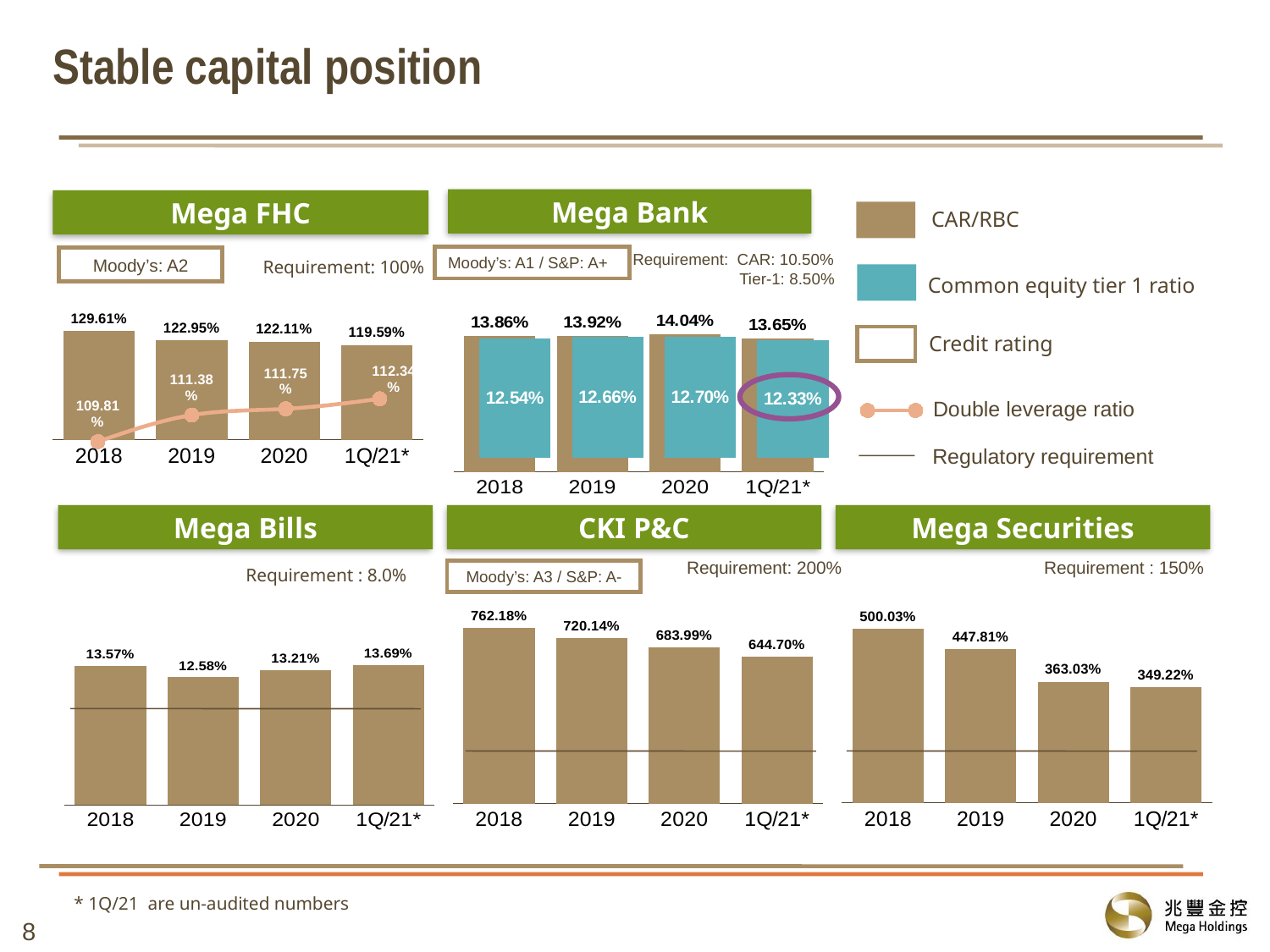
In the Mega FHC chart, what is the CAR/RBC value for 2018? 129.61% In the Mega Securities chart, which is larger, the value for 2020 or the value for 1Q/21*? 2020 How many periods are shown on the x axis of the Mega Bills chart? 4 In the Mega Bank chart, what is the common equity tier 1 ratio for 2020? 12.70% In the Mega FHC chart, what is the double leverage ratio for 1Q/21*? 112.34% In the CKI P&C chart, do the values rise or fall from 2018 to 1Q/21*? fall In the Mega FHC chart, does the double leverage ratio rise or fall from 2018 to 1Q/21*? rise In the Mega Bills chart, which year has the lowest value? 2019 In the Mega Bank chart, which year has the highest CAR/RBC value? 2020 In the Mega Securities chart, what is the value for 2019? 447.81% In the CKI P&C chart, what is the difference between the 2018 value and the 1Q/21* value? 117.48 percentage points In the Mega Bank chart, what is the difference between the CAR/RBC and the common equity tier 1 ratio in 2019? 1.26 percentage points